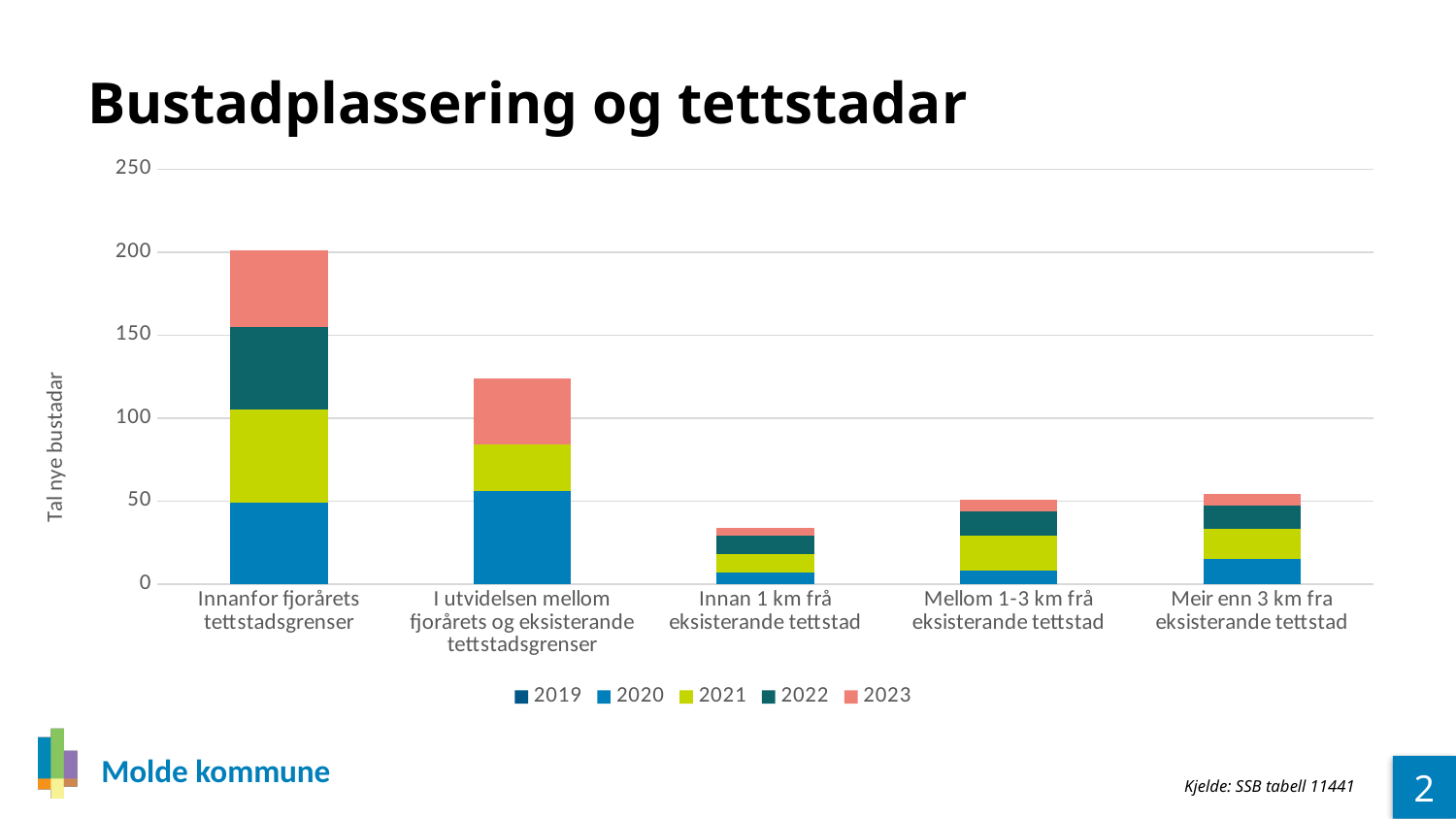
How many series does the legend list? 5 Which category has the shortest stacked bar? Innan 1 km frå eksisterande tettstad Which has the larger total: 'Innan 1 km frå eksisterande tettstad' or 'Meir enn 3 km fra eksisterande tettstad'? Meir enn 3 km fra eksisterande tettstad Which has the larger total: 'Innanfor fjorårets tettstadsgrenser' or 'I utvidelsen mellom fjorårets og eksisterande tettstadsgrenser'? Innanfor fjorårets tettstadsgrenser Is the total stacked value for 'I utvidelsen mellom fjorårets og eksisterande tettstadsgrenser' greater or less than 100? greater Which category has the tallest stacked bar? Innanfor fjorårets tettstadsgrenser What is the label on the y axis? Tal nye bustadar How many categories are shown along the x axis? 5 Is the total stacked value for 'Innan 1 km frå eksisterande tettstad' greater or less than 50? less What is the title of the chart on the slide? Bustadplassering og tettstadar Is the total stacked value for 'Innanfor fjorårets tettstadsgrenser' greater or less than 150? greater What kind of chart is shown on the slide? Stacked bar chart